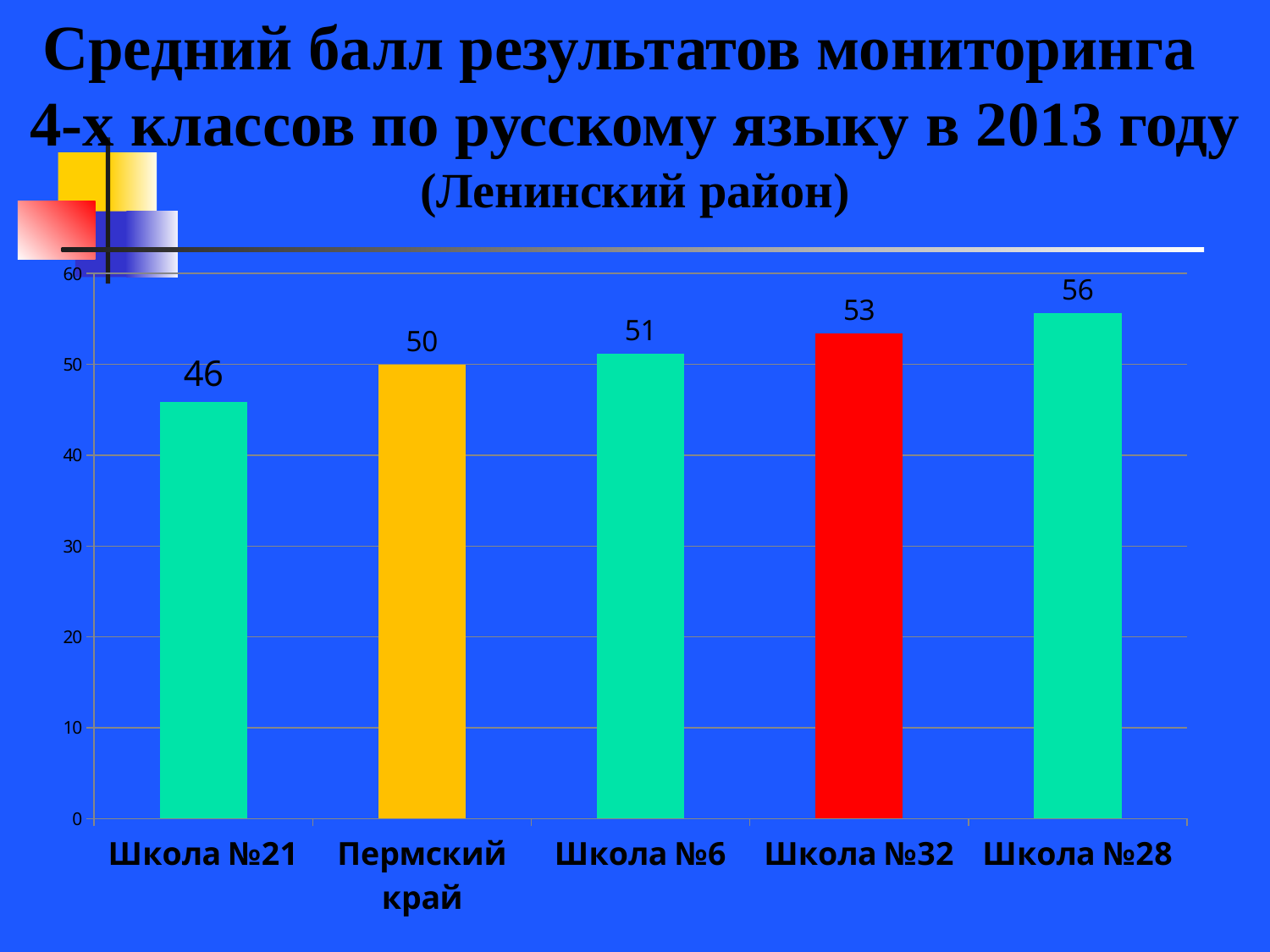
Which category has the lowest value? Школа №21 Is the value for Школа №28 greater or less than 50? greater What is the value for Школа №32? 53 What is the value for Пермский край? 50 What is the difference between the values for Школа №28 and Школа №21? 10 Which bar is coloured red? Школа №32 How many categories are shown on the x axis? 5 What is the difference between the values for Школа №32 and Пермский край? 3 Which category has the highest value? Школа №28 Which is larger, the value for Школа №6 or the value for Школа №21? Школа №6 What is the value for Школа №21? 46 What kind of chart is shown on the slide? bar chart